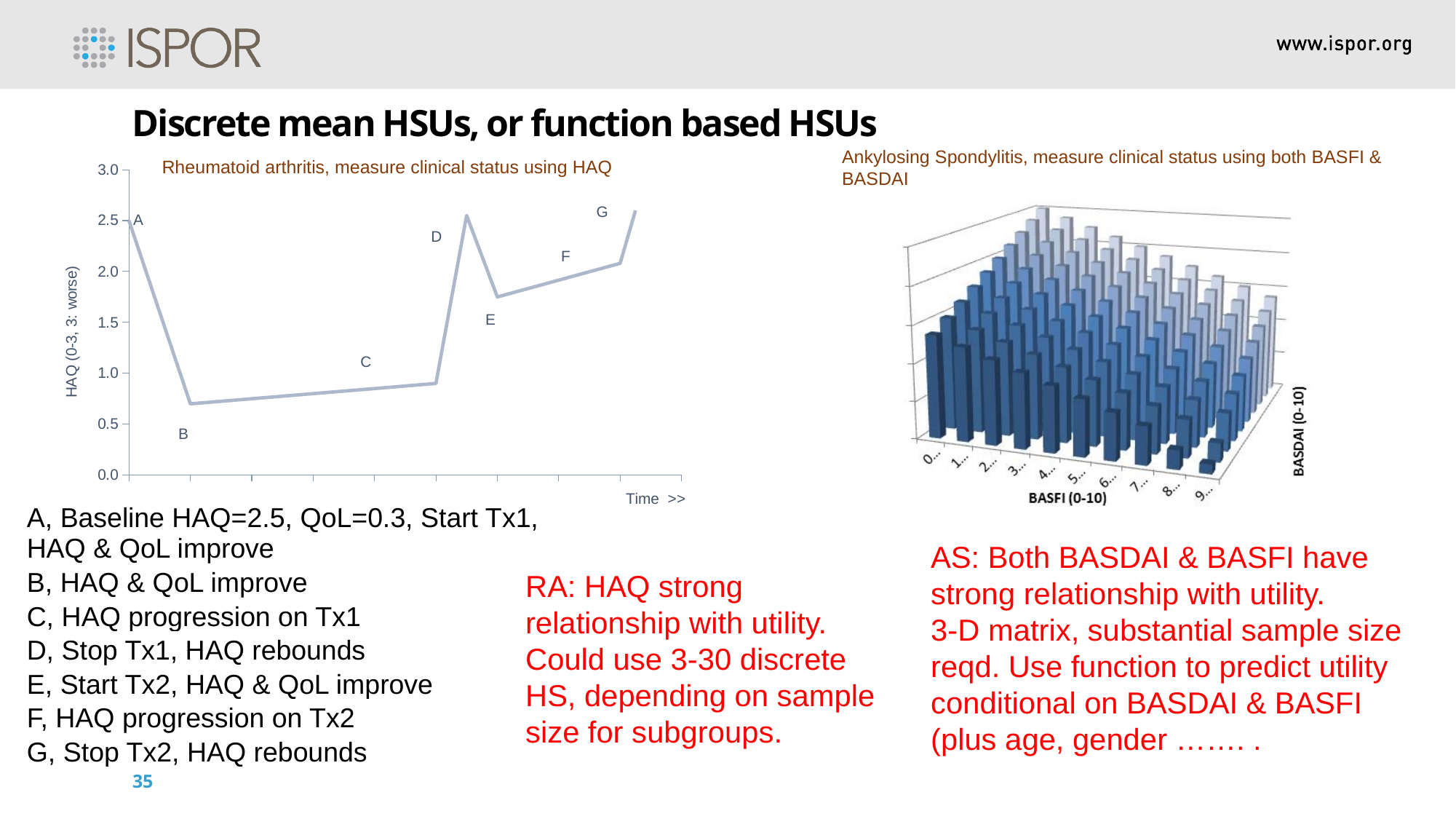
What kind of chart is the left chart titled 'Rheumatoid arthritis, measure clinical status using HAQ'? line chart In the right chart, what is the label on the front horizontal axis? BASFI (0-10) What kind of chart is the right chart for Ankylosing Spondylitis? bar chart In the left chart, which labeled point has the lowest HAQ value? B In the left chart, is the HAQ value at point E greater or less than 2.0? less In the left chart, is the HAQ value at point D greater or less than 2.0? greater What is the title of the left chart? Rheumatoid arthritis, measure clinical status using HAQ In the left chart, does the HAQ value rise or fall from point A to point B? fall In the left chart, what is the HAQ value at point A (baseline)? 2.5 In the left chart, is the HAQ value at point B greater or less than 1.0? less In the left chart, how many labeled points (A to G) are shown on the line? 7 In the left chart, which has the higher HAQ value, point A or point B? A